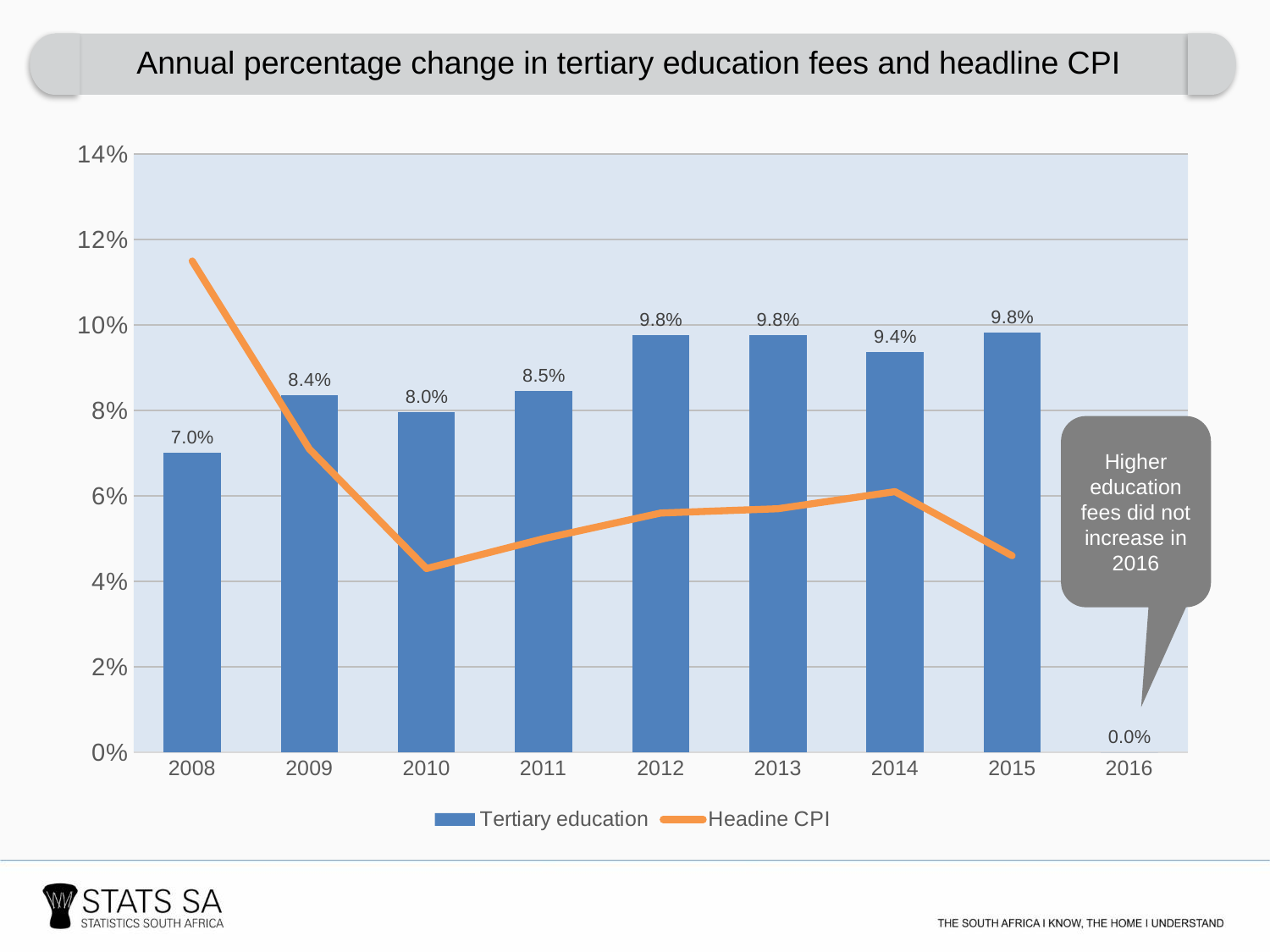
Which is larger, the Tertiary education value for 2009 or for 2010? 2009 What is the value for Tertiary education in 2016? 0.0% Is the Headine CPI value for 2010 greater or less than 6%? less What is the value for Tertiary education in 2008? 7.0% What is the difference between the Tertiary education values for 2015 and 2008? 2.8% Which year has the lowest value for Tertiary education? 2016 Does the Headine CPI line rise or fall from 2008 to 2010? fall What is the value for Tertiary education in 2014? 9.4% How many series does the legend list? 2 How many years are shown on the x axis? 9 Is the Headine CPI value for 2008 greater or less than 10%? greater What does the callout box on the chart say? Higher education fees did not increase in 2016